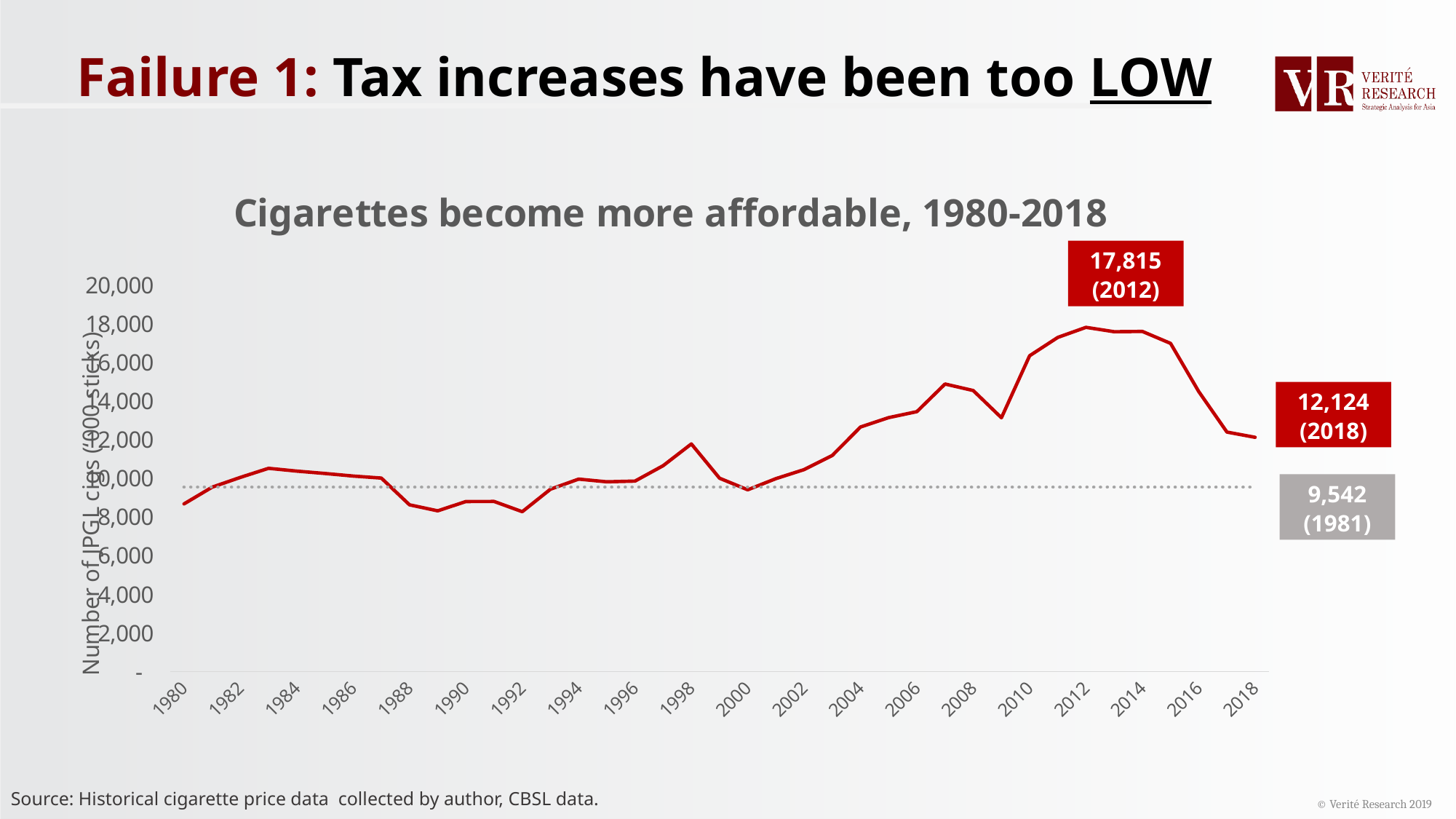
What is the difference between the labelled 2018 value and the labelled 1981 value? 2,582 Does the line rise or fall between 2012 and 2018? fall Is the value for 1992 greater or less than 10,000? less What kind of chart is shown on the slide? line chart What is the title of the chart? Cigarettes become more affordable, 1980-2018 Is the value for 1998 greater or less than 10,000? greater What value is labelled for 2018 on the chart? 12,124 What value is labelled for 2012 on the chart? 17,815 What value is labelled for 1981 on the chart? 9,542 Which year has the larger labelled value, 2012 or 2018? 2012 What is the difference between the labelled 2012 value and the labelled 2018 value? 5,691 In which year does the line reach its highest point? 2012